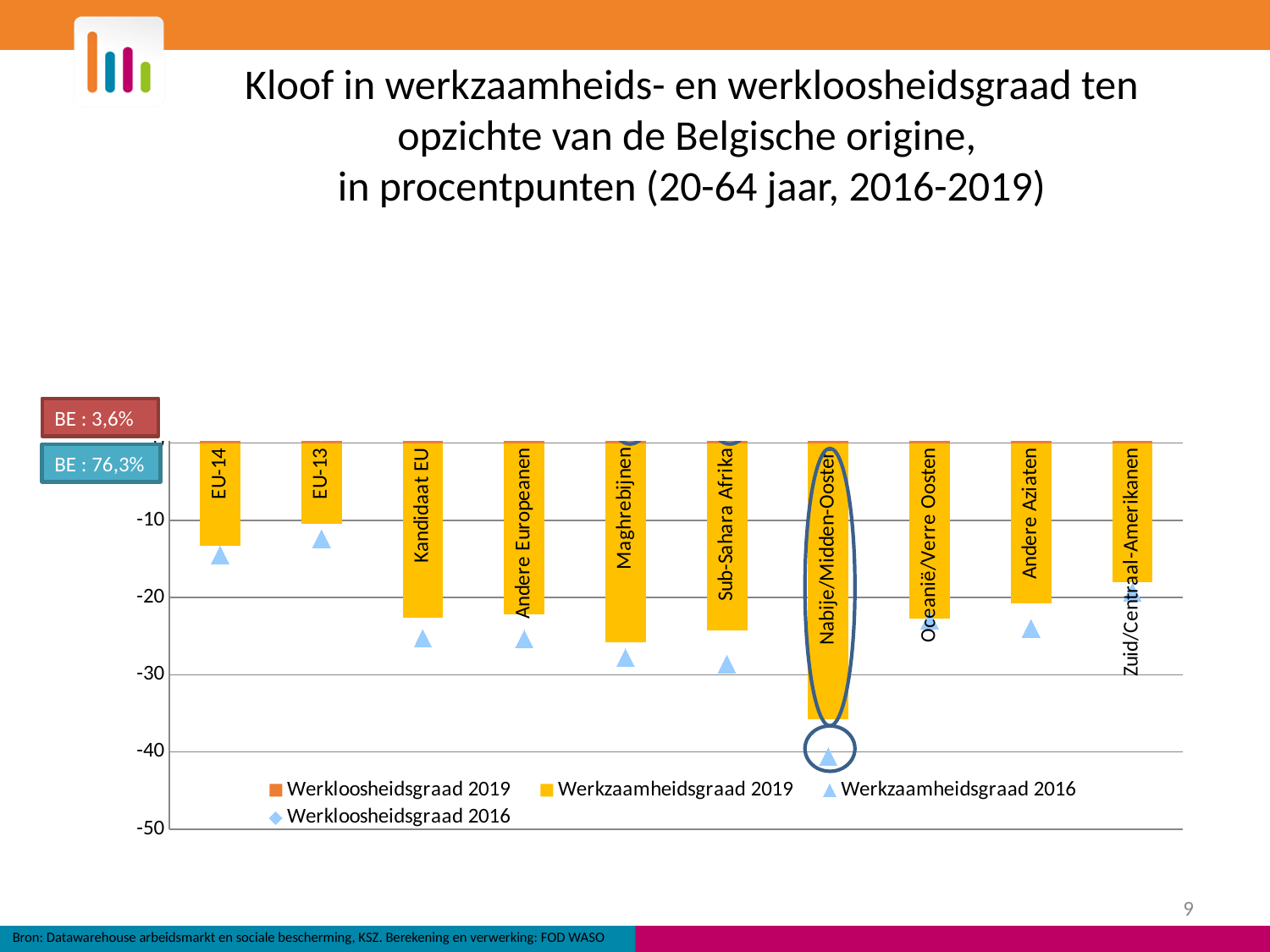
Which category has the lowest (most negative) Werkzaamheidsgraad 2019 bar? Nabije/Midden-Oosten Is the Werkzaamheidsgraad 2019 value for EU-13 greater or less than -20? greater Is the Werkzaamheidsgraad 2019 value for Nabije/Midden-Oosten greater or less than -30? less Is the Werkzaamheidsgraad 2019 value for Kandidaat EU greater or less than -20? less What Belgian reference value is shown in the blue box next to the chart? BE : 76,3% How many series does the chart legend list? 4 How many origin categories are shown on the x axis of the chart? 10 Which has the larger (less negative) Werkzaamheidsgraad 2019 value, Andere Aziaten or Nabije/Midden-Oosten? Andere Aziaten What kind of chart is shown on the slide? combination bar and line chart (bars with triangle markers) Which has the larger (less negative) Werkzaamheidsgraad 2019 value, EU-14 or Maghrebijnen? EU-14 Which category has the highest (least negative) Werkzaamheidsgraad 2019 bar? EU-13